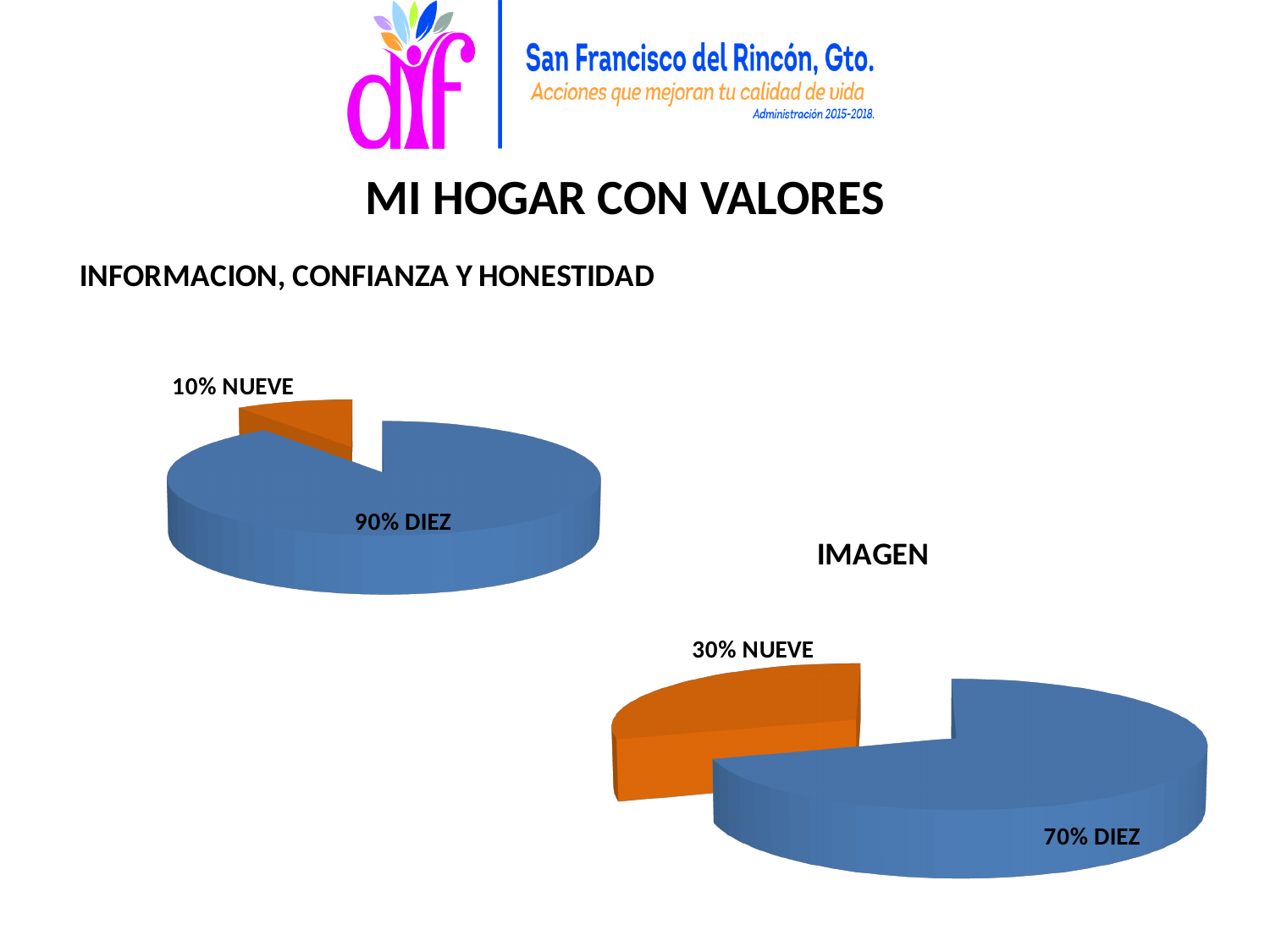
Which chart has the larger NUEVE share, 'INFORMACION, CONFIANZA Y HONESTIDAD' or 'IMAGEN'? IMAGEN In the 'IMAGEN' pie chart, what is the difference between the DIEZ and NUEVE shares? 40% In the 'IMAGEN' pie chart, which slice is the smallest? NUEVE In the 'IMAGEN' pie chart, what colour is the NUEVE slice? Orange In the 'IMAGEN' pie chart, what share does DIEZ have? 70% In the 'INFORMACION, CONFIANZA Y HONESTIDAD' pie chart, what is the difference between the DIEZ and NUEVE shares? 80% In the 'INFORMACION, CONFIANZA Y HONESTIDAD' pie chart, what share does DIEZ have? 90% What kind of chart is used for 'INFORMACION, CONFIANZA Y HONESTIDAD'? Pie chart In the 'INFORMACION, CONFIANZA Y HONESTIDAD' pie chart, which slice is the largest? DIEZ In the 'INFORMACION, CONFIANZA Y HONESTIDAD' pie chart, what share does NUEVE have? 10% How many slices does the 'IMAGEN' pie chart have? 2